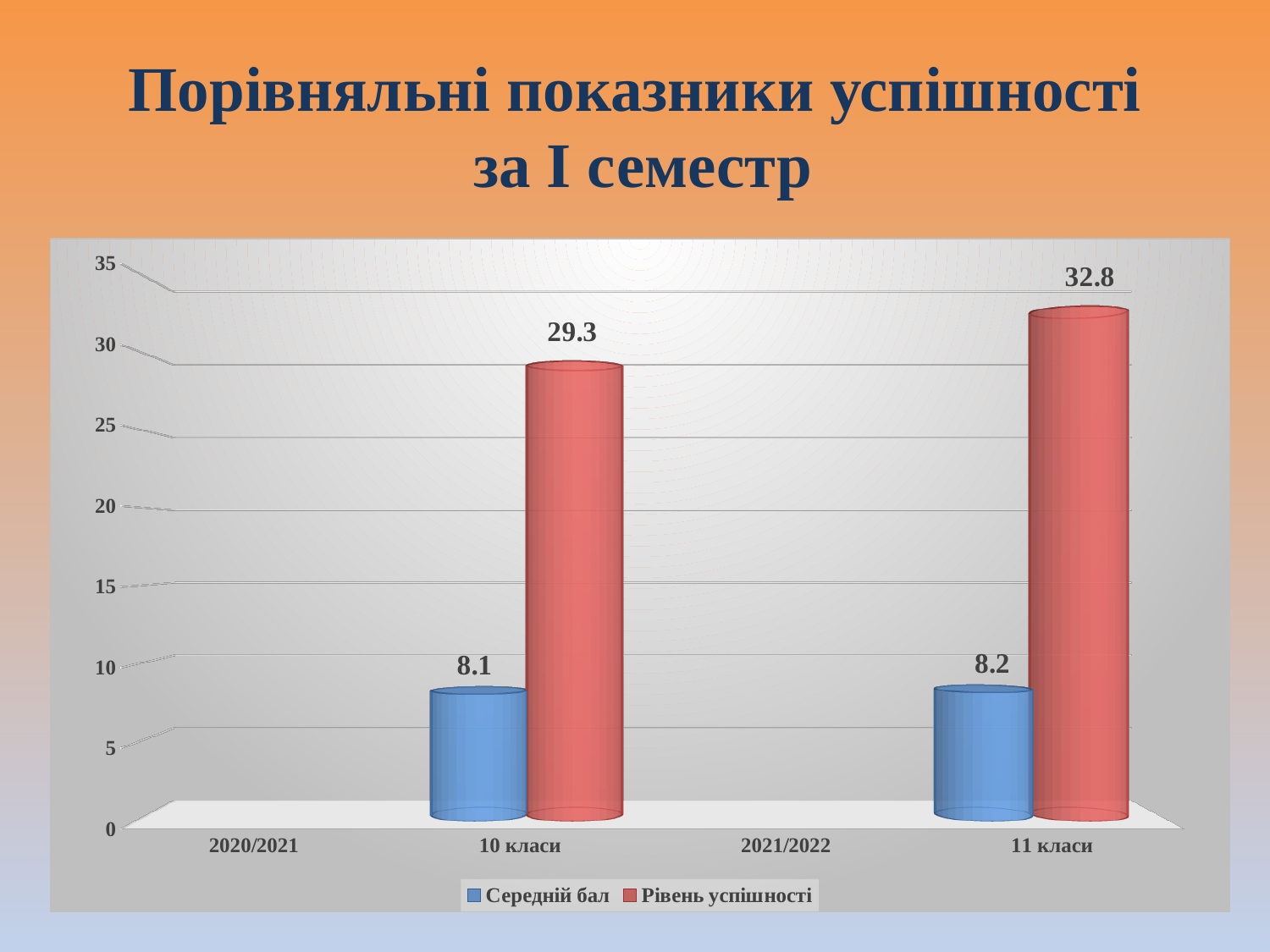
What kind of chart is shown on the slide? bar chart How many series does the legend list? 2 What is the difference between the Рівень успішності values for 11 класи and 10 класи? 3.5 What is the value of Рівень успішності for 10 класи? 29.3 What is the value of Середній бал for 11 класи? 8.2 What is the value of Рівень успішності for 11 класи? 32.8 Which is larger: Рівень успішності for 10 класи or Рівень успішності for 11 класи? 11 класи What colour are the Середній бал bars? blue What is the difference between the Середній бал values for 11 класи and 10 класи? 0.1 Which category has the highest Рівень успішності value? 11 класи Is the Рівень успішності value for 11 класи greater or less than 30? greater What is the value of Середній бал for 10 класи? 8.1